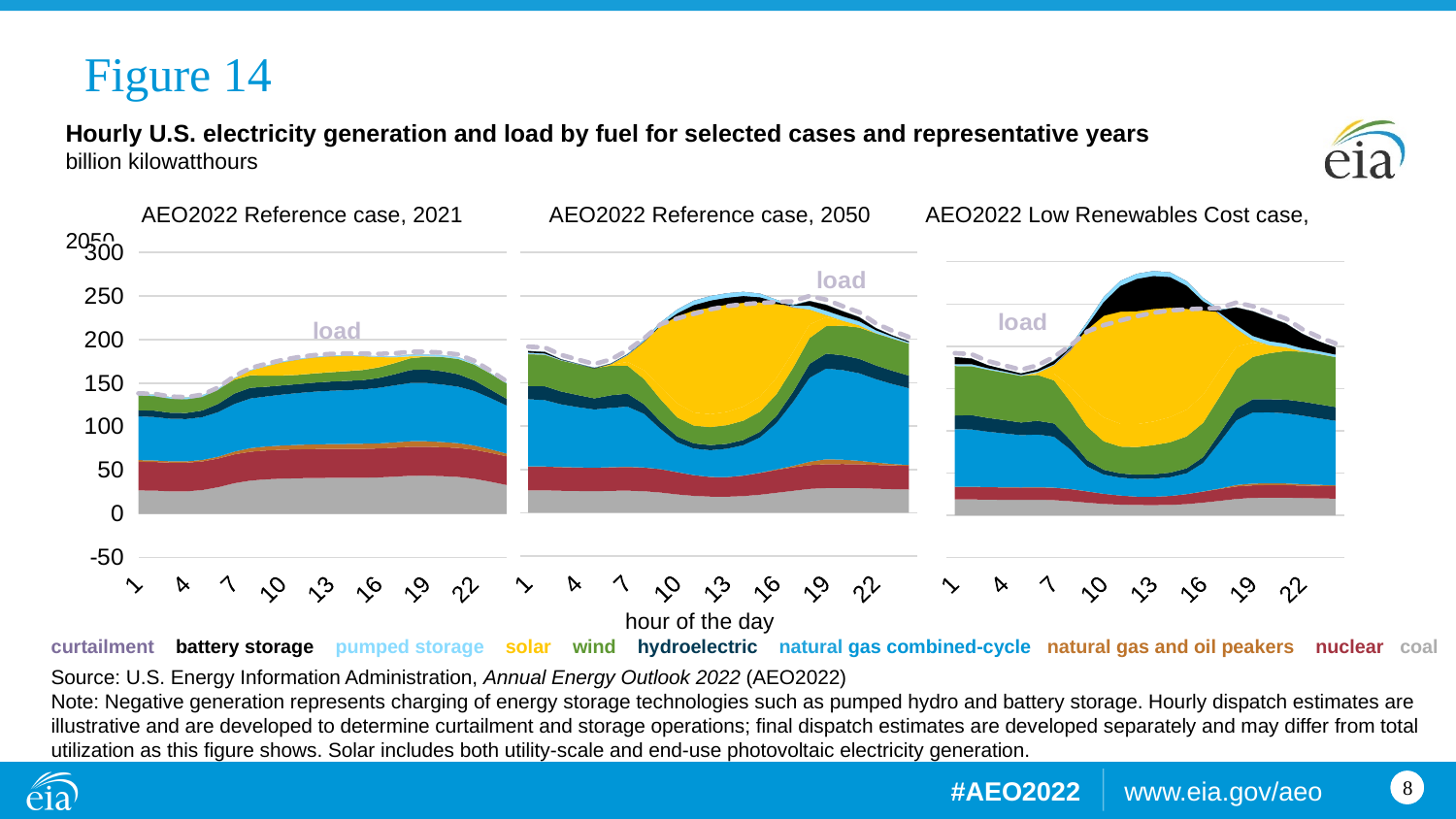
How many chart panels are shown on the slide? 3 Which chart shows a larger coal band: AEO2022 Reference case, 2021 or AEO2022 Low Renewables Cost case, 2050? AEO2022 Reference case, 2021 In the AEO2022 Reference case, 2021 chart, does the load line rise or fall from hour 1 to hour 13? rise In the AEO2022 Reference case, 2021 chart, is the peak value of the load line greater or less than 200? less What unit is used on the y axis of the charts? billion kilowatthours In the AEO2022 Low Renewables Cost case, 2050 chart, is the peak of the total stacked generation (including curtailment) greater or less than 250? greater In the AEO2022 Reference case, 2050 chart, is the load at hour 4 greater or less than 200? less What kind of chart is used in each of the three panels on this slide? Stacked area chart What is the x-axis label shared by the three charts? hour of the day Which chart shows a larger midday solar band: AEO2022 Reference case, 2021 or AEO2022 Reference case, 2050? AEO2022 Reference case, 2050 How many fuel/technology series does the legend at the bottom of the slide list? 10